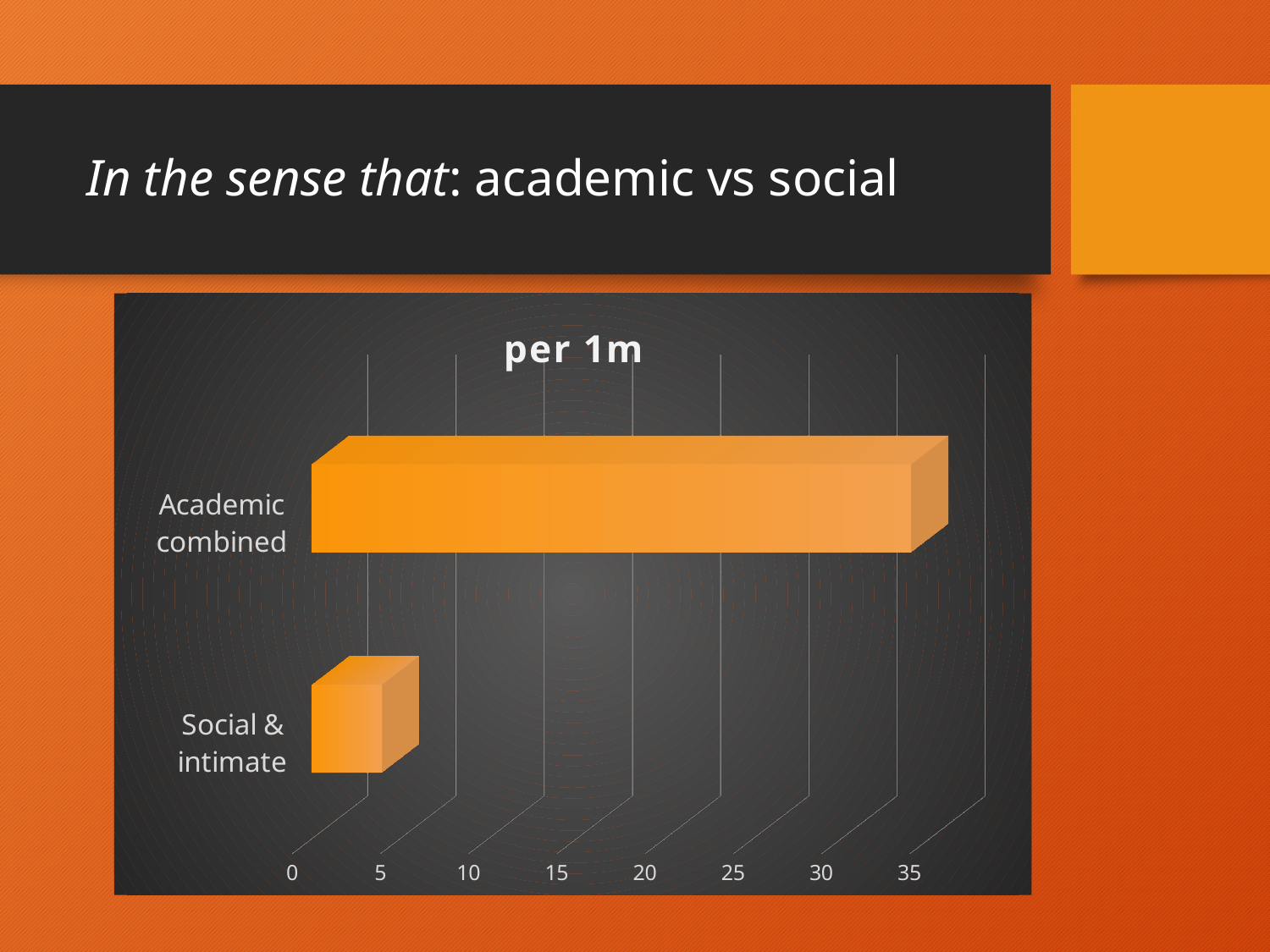
Which is larger, the value for Academic combined or the value for Social & intimate? Academic combined Which category has the lowest value? Social & intimate What kind of chart is shown on the slide? bar chart Which category has the highest value? Academic combined What is the highest value shown on the horizontal axis? 35 Is the value for Academic combined greater or less than 30? greater Is the value for Social & intimate greater or less than 10? less How many categories are plotted in the chart? 2 Is the value for Academic combined greater or less than 20? greater What is the title of the chart? per 1m